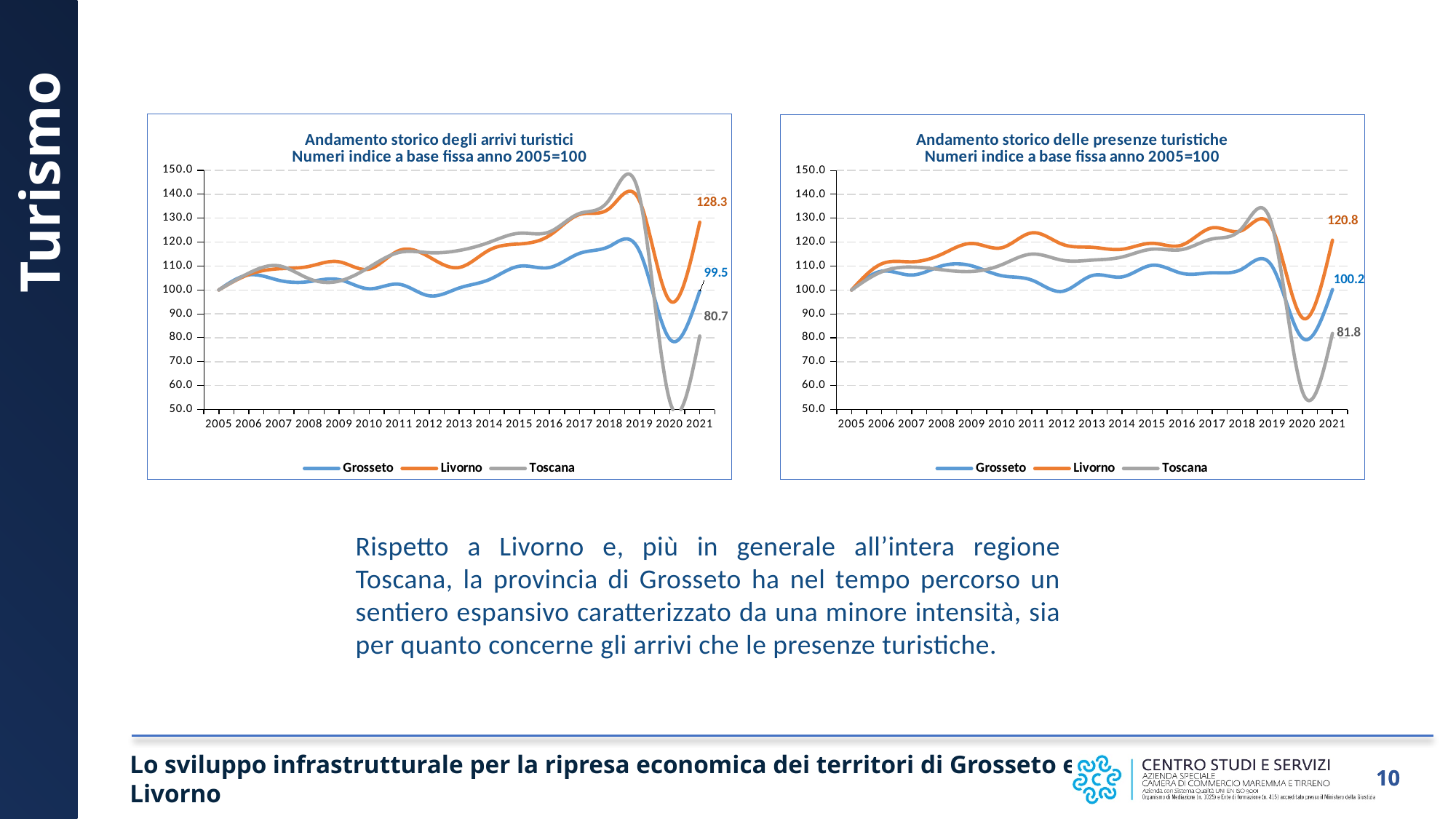
In the chart 'Andamento storico degli arrivi turistici', what is the value for Grosseto in 2021? 99.5 How many series does the legend of the chart 'Andamento storico delle presenze turistiche' list? 3 In the chart 'Andamento storico delle presenze turistiche', what is the value for Livorno in 2021? 120.8 In the chart 'Andamento storico degli arrivi turistici', which series has the highest value in 2021? Livorno In the chart 'Andamento storico delle presenze turistiche', what is the value for Toscana in 2021? 81.8 In the chart 'Andamento storico degli arrivi turistici', what is the value for Livorno in 2021? 128.3 What kind of chart is 'Andamento storico delle presenze turistiche'? Line chart In the chart 'Andamento storico degli arrivi turistici', is the value for Toscana in 2020 greater or less than 60.0? less In the chart 'Andamento storico delle presenze turistiche', which series has the lowest value in 2021? Toscana In the chart 'Andamento storico degli arrivi turistici', what is the difference between the 2021 values for Livorno and Grosseto? 28.8 How many years are shown on the x axis of the chart 'Andamento storico degli arrivi turistici'? 17 In the chart 'Andamento storico delle presenze turistiche', what is the difference between the 2021 values for Grosseto and Toscana? 18.4